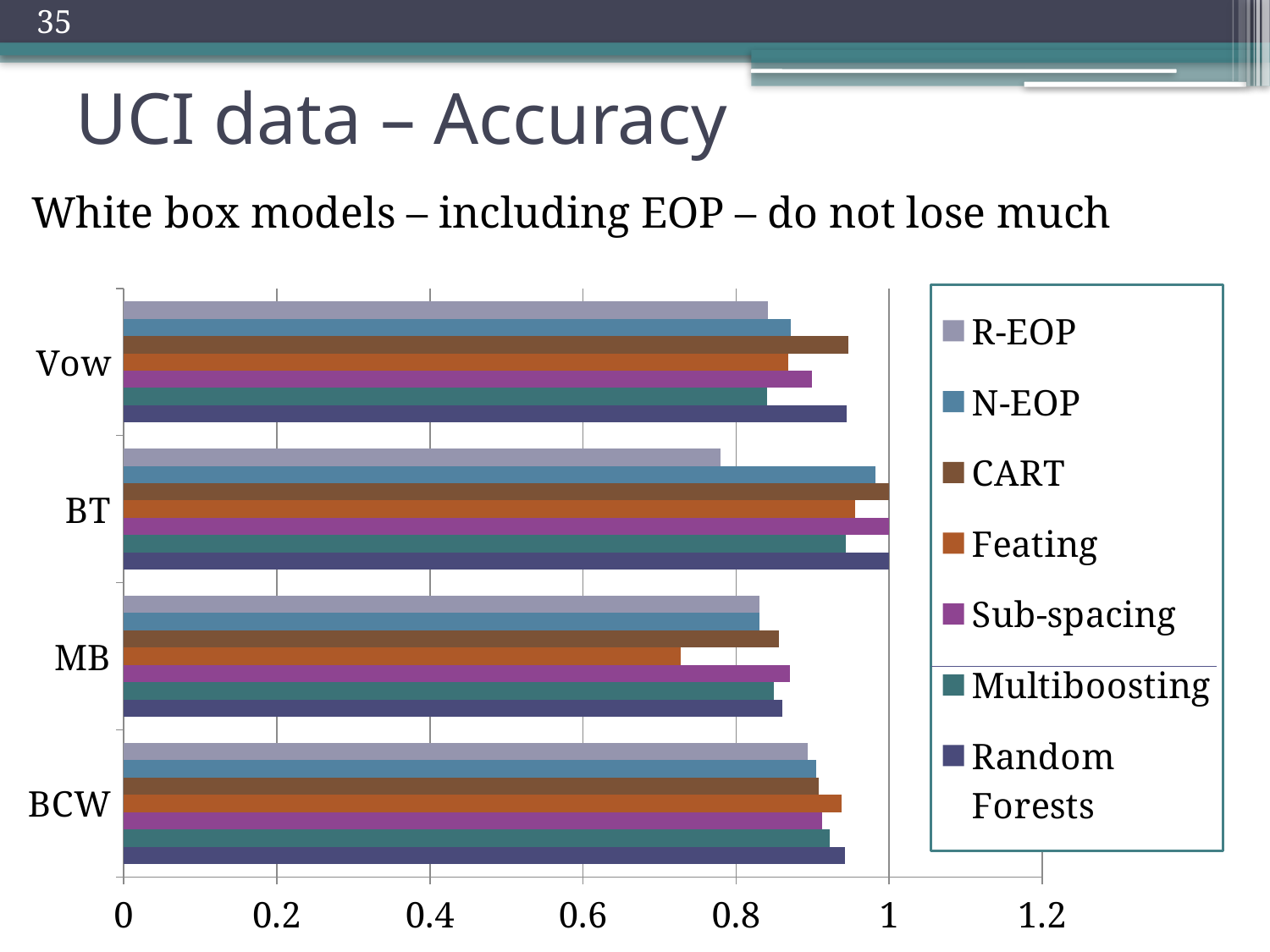
What kind of chart is shown on the slide? bar chart Is the accuracy of CART on the Vow dataset greater or less than 0.8? greater How many series does the chart's legend list? 7 Is the accuracy of Feating on the MB dataset greater or less than 0.8? less For the BT dataset, which has the higher accuracy: R-EOP or N-EOP? N-EOP For the MB dataset, which has the higher accuracy: CART or Feating? CART Which series has the lowest accuracy for the BT dataset? R-EOP What is the highest value shown on the chart's x axis? 1.2 Is the accuracy of Random Forests on the BCW dataset greater or less than 0.8? greater Which series has the lowest accuracy for the MB dataset? Feating Which series is listed last in the chart's legend? Random Forests How many datasets (categories) are shown on the y axis of the chart? 4